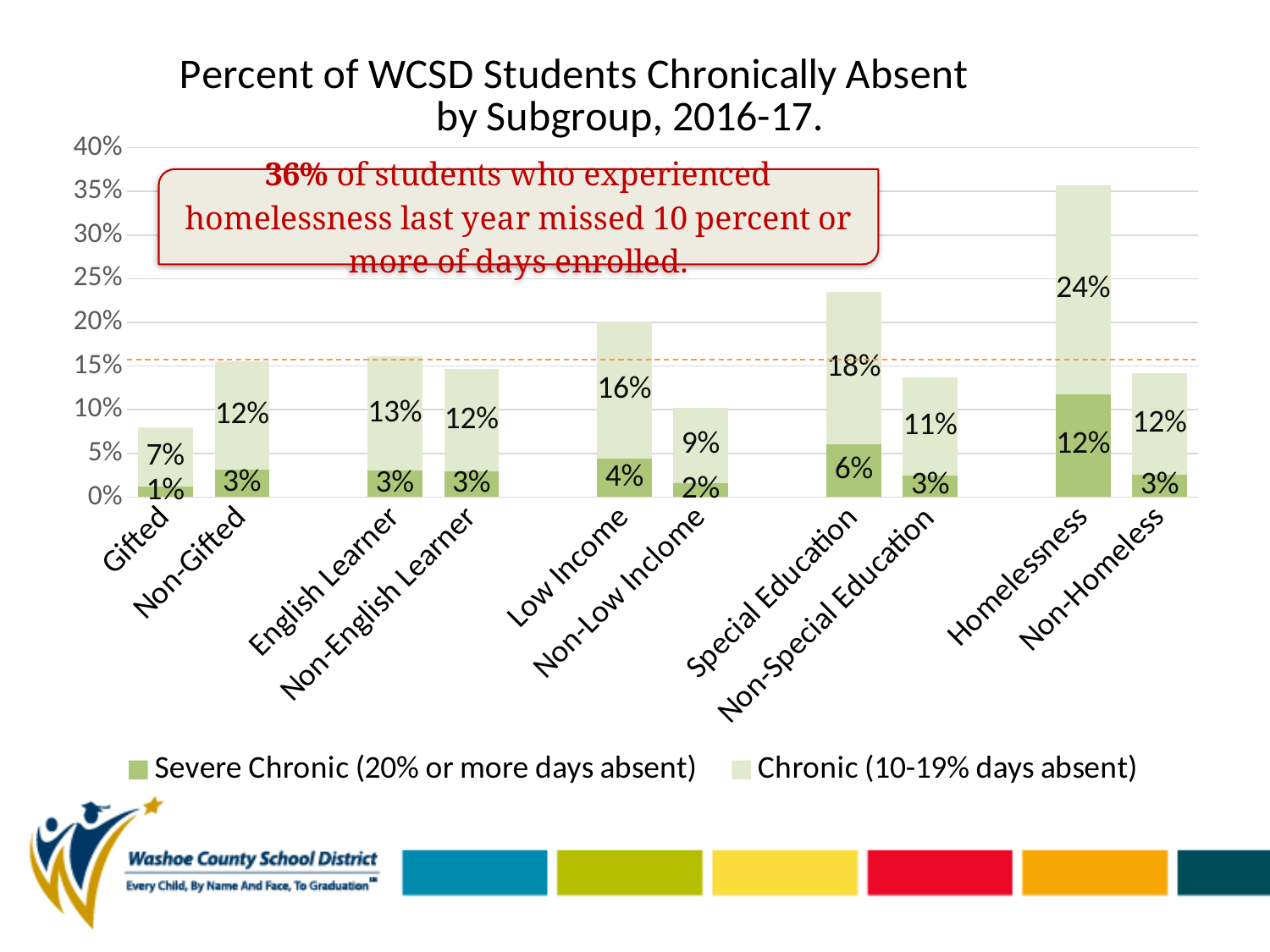
What is the Severe Chronic (20% or more days absent) value for the Special Education subgroup? 6% Which subgroup has the lowest Severe Chronic (20% or more days absent) value? Gifted What is the Chronic (10-19% days absent) value for the Homelessness subgroup? 24% What is the title of the chart? Percent of WCSD Students Chronically Absent by Subgroup, 2016-17. How many series does the legend list? 2 What kind of chart is shown on the slide? Stacked bar chart What is the Chronic (10-19% days absent) value for Low Income students? 16% What is the difference between the Chronic (10-19% days absent) values for Low Income and Non-Low Income students? 7% Which subgroup has the highest Severe Chronic (20% or more days absent) value? Homelessness What is the total percent chronically absent (both series combined) for the Homelessness subgroup? 36% How many subgroups (categories) are shown on the x axis? 10 Which is larger: the Chronic (10-19% days absent) value for English Learner or for Non-English Learner? English Learner